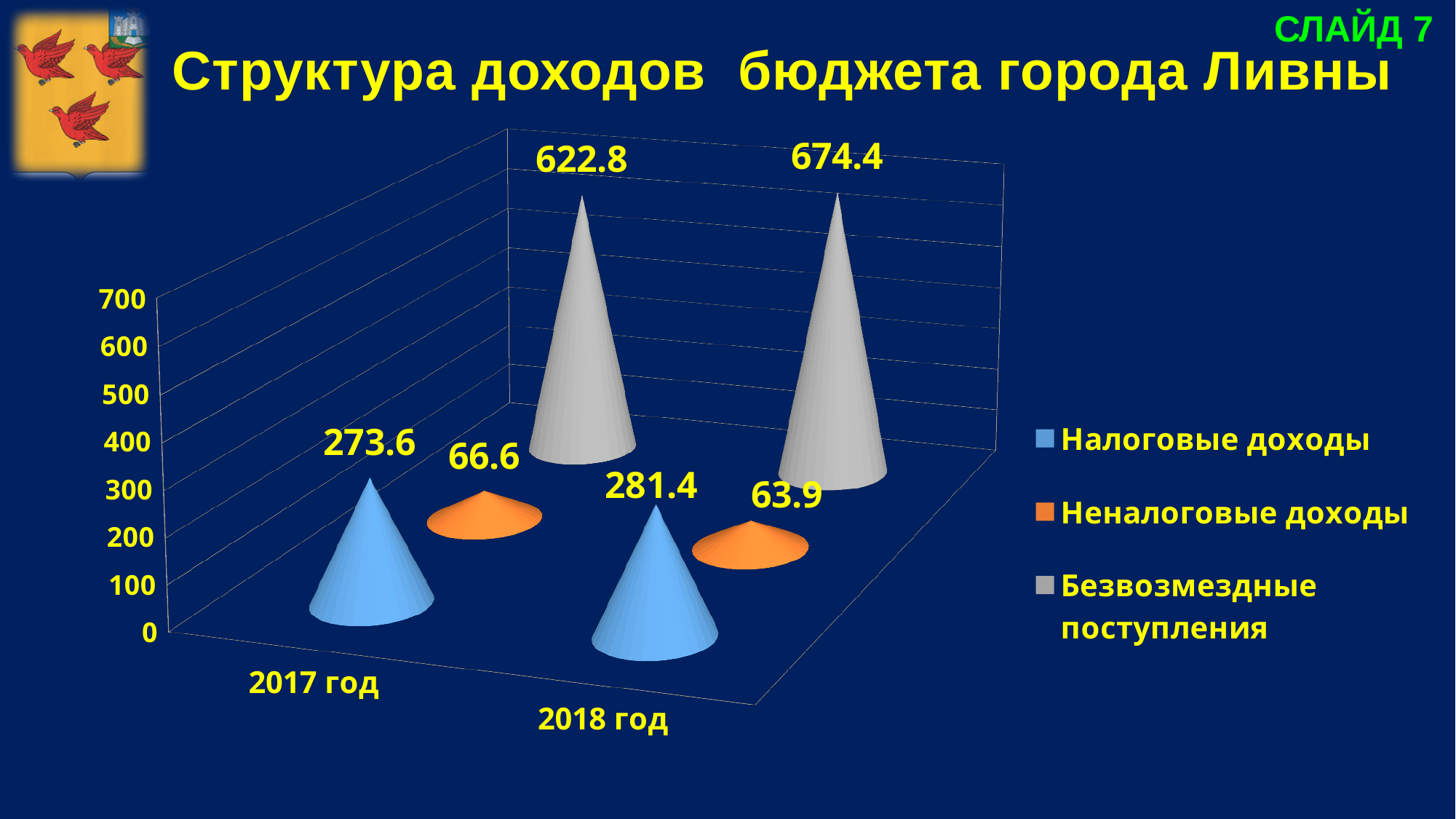
How many series does the legend list? 3 What is the difference between Безвозмездные поступления in 2018 год and 2017 год? 51.6 Does the value of Неналоговые доходы rise or fall from 2017 год to 2018 год? fall Which is larger: Налоговые доходы in 2017 год or in 2018 год? 2018 год What is the value of Неналоговые доходы for 2018 год? 63.9 What is the value of Безвозмездные поступления for 2018 год? 674.4 What is the title of the slide? Структура доходов бюджета города Ливны Which series has the highest value in 2017 год? Безвозмездные поступления How many years (categories) are shown on the x axis? 2 What is the value of Налоговые доходы for 2017 год? 273.6 Which series has the lowest value in 2018 год? Неналоговые доходы Is the value of Безвозмездные поступления for 2017 год greater or less than 600? greater